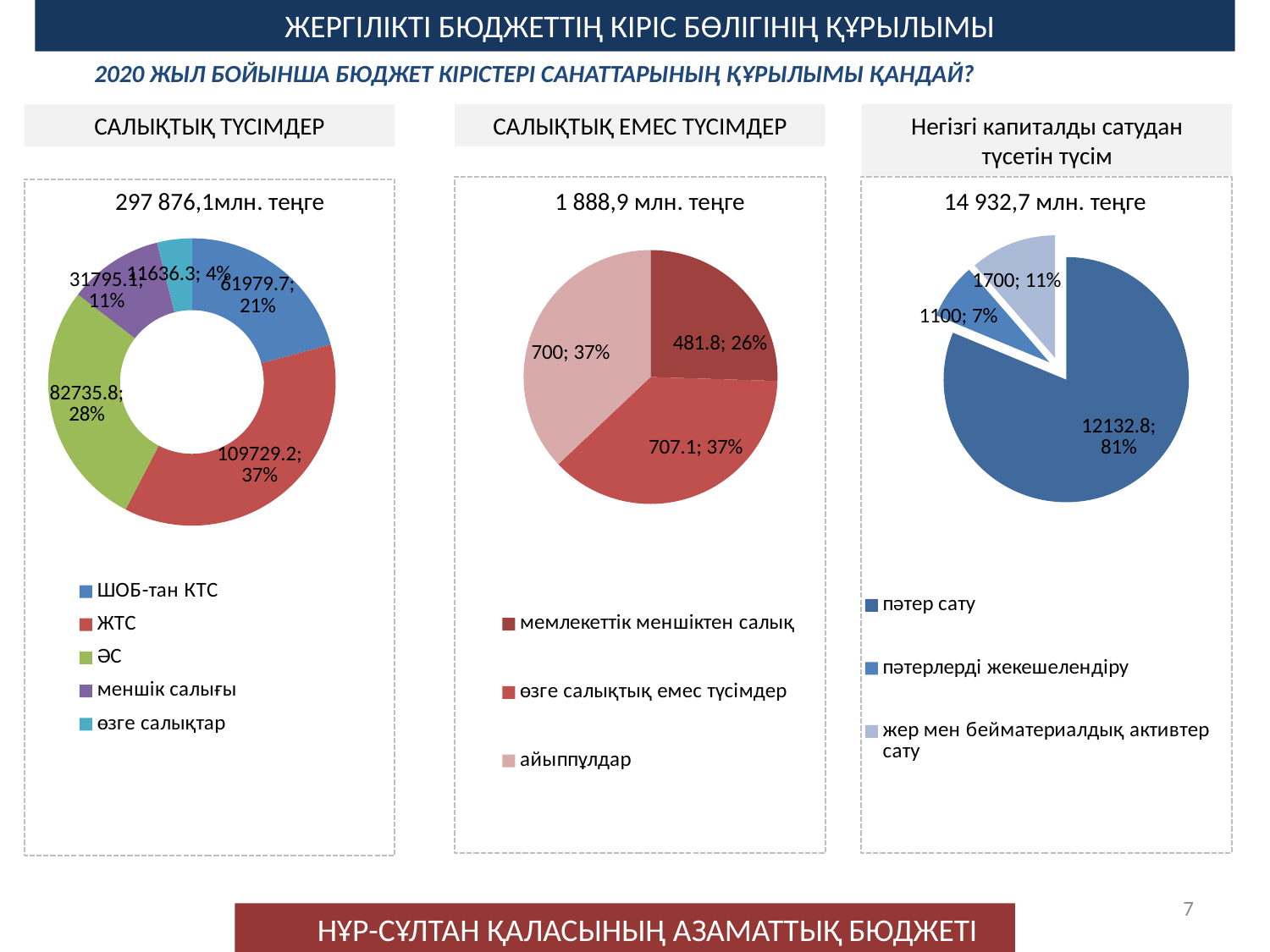
In the Негізгі капиталды сатудан түсетін түсім chart, what value is shown for жер мен бейматериалдық активтер сату? 1700; 11% In the Негізгі капиталды сатудан түсетін түсім chart, what percentage share does пәтерлерді жекешелендіру have? 7% How many categories does the legend of the САЛЫҚТЫҚ ТҮСІМДЕР chart list? 5 In the САЛЫҚТЫҚ ТҮСІМДЕР chart, what percentage share does ӘС have? 28% In the САЛЫҚТЫҚ ЕМЕС ТҮСІМДЕР chart, what is the difference between the values for өзге салықтық емес түсімдер and айыппұлдар? 7.1 In the Негізгі капиталды сатудан түсетін түсім chart, which category has the largest share? пәтер сату What total amount is shown above the САЛЫҚТЫҚ ЕМЕС ТҮСІМДЕР chart? 1 888,9 млн. теңге In the САЛЫҚТЫҚ ТҮСІМДЕР chart, what value is shown for ЖТС? 109729.2; 37% In the САЛЫҚТЫҚ ТҮСІМДЕР chart, which category has the smallest share? өзге салықтар In the САЛЫҚТЫҚ ТҮСІМДЕР chart, which is larger: ШОБ-тан КТС or меншік салығы? ШОБ-тан КТС What type of chart is used in the САЛЫҚТЫҚ ЕМЕС ТҮСІМДЕР panel? Pie chart In the САЛЫҚТЫҚ ЕМЕС ТҮСІМДЕР chart, what value is shown for мемлекеттік меншіктен салық? 481.8; 26%